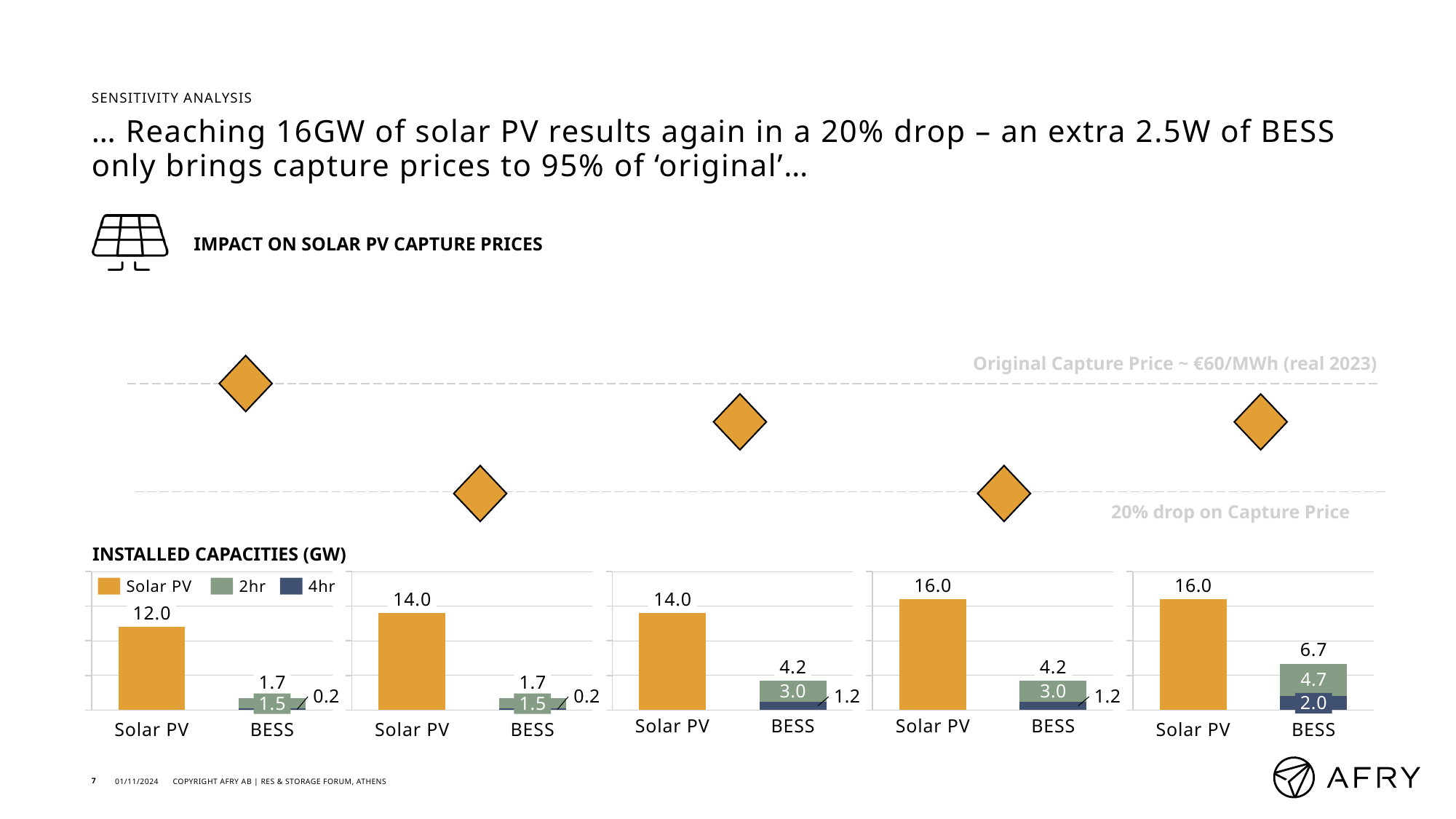
In the leftmost installed capacities chart, what is the value for Solar PV? 12.0 In the middle installed capacities chart, what is the total of the stacked BESS bar? 4.2 In the rightmost installed capacities chart, what is the total of the stacked BESS bar? 6.7 In the fourth installed capacities chart from the left, what is the difference between the Solar PV value and the BESS total? 11.8 How many series does the legend of the installed capacities charts list? 3 In the rightmost installed capacities chart, what is the 4hr value for BESS? 2.0 What colour represents Solar PV in the installed capacities charts? Orange In the leftmost installed capacities chart, which category has the higher value, Solar PV or BESS? Solar PV What kind of chart is used for the installed capacities? Bar chart How many categories are shown on the x axis of the leftmost installed capacities chart? 2 In the second installed capacities chart from the left, what is the 4hr value for BESS? 0.2 In the rightmost installed capacities chart, what is the 2hr value for BESS? 4.7